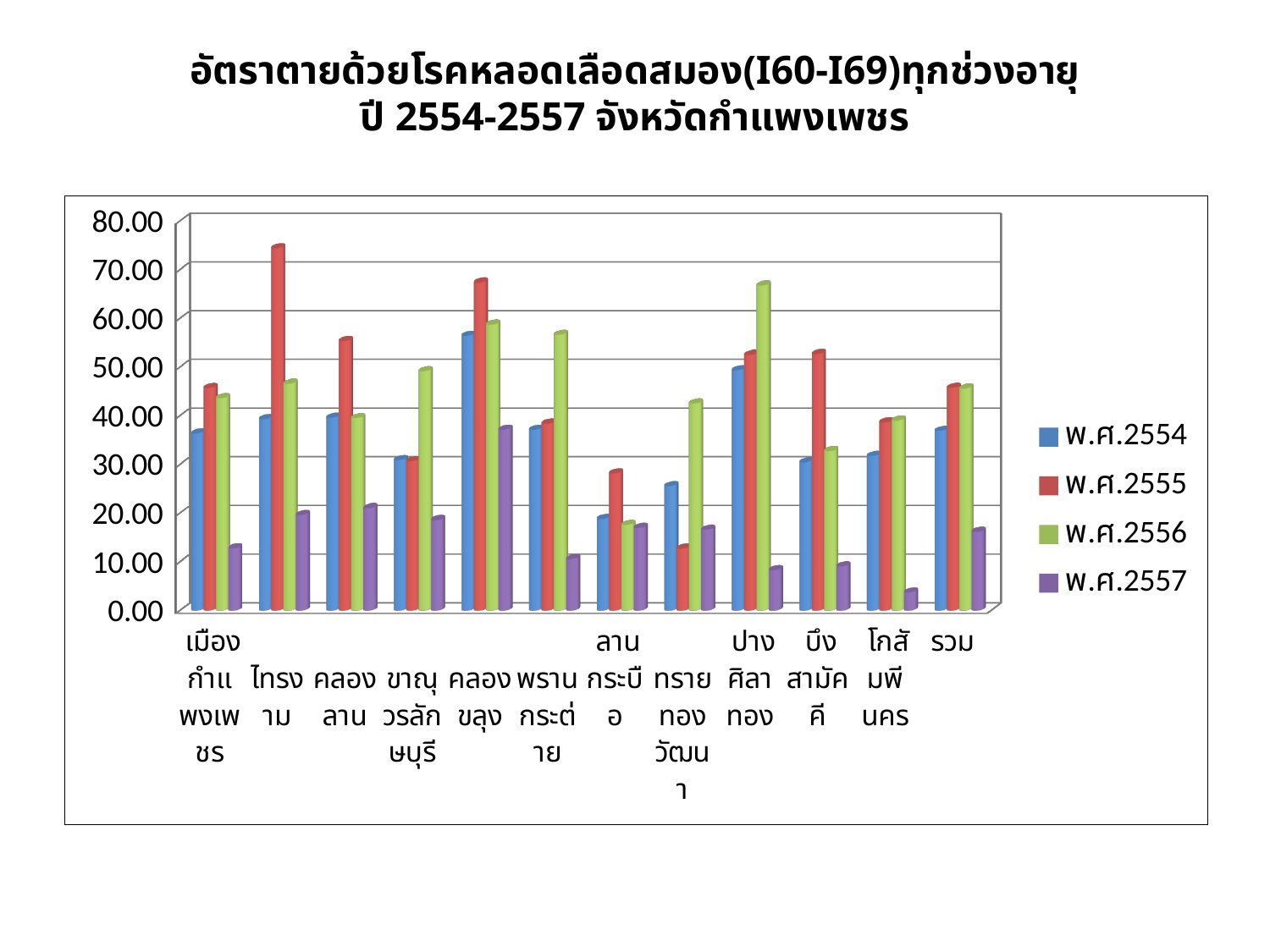
Which category has the highest value for พ.ศ.2555? ไทรงาม What kind of chart is shown on the slide? bar chart Is the value for ปางศิลาทอง in พ.ศ.2556 greater or less than 60.00? greater How many categories are shown along the x axis? 12 What are the series names listed in the legend? พ.ศ.2554, พ.ศ.2555, พ.ศ.2556, พ.ศ.2557 Which category has the highest value for พ.ศ.2556? ปางศิลาทอง Is the value for ไทรงาม in พ.ศ.2555 greater or less than 70.00? greater Which category has the lowest value for พ.ศ.2557? โกสัมพีนคร Which is larger for พ.ศ.2554: คลองขลุง or ลานกระบือ? คลองขลุง Is the value for ทรายทองวัฒนา in พ.ศ.2555 greater or less than 20.00? less For ไทรงาม, which series has the larger value: พ.ศ.2555 or พ.ศ.2556? พ.ศ.2555 How many series does the legend list? 4